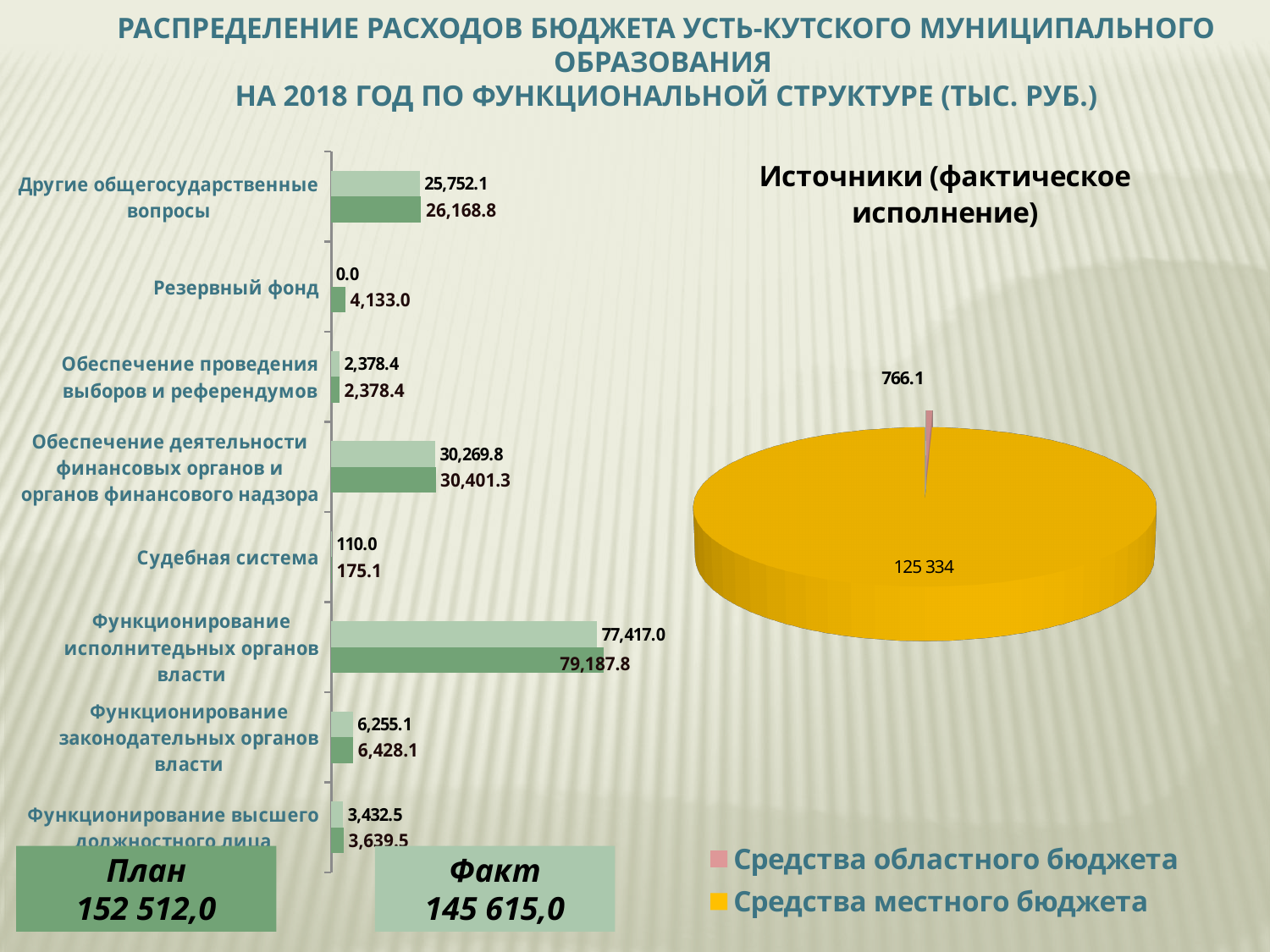
In the bar chart on the left, which category has the highest План (dark green) value? Функционирование исполнительных органов власти In the bar chart on the left, which is larger for «Функционирование законодательных органов власти»: the План value or the Факт value? План (6,428.1) What type of chart is the chart on the left of the slide? Bar chart In the bar chart on the left, what is the План (dark green) value for «Функционирование исполнительных органов власти»? 79,187.8 In the bar chart on the left, what is the Факт (light green) value for «Резервный фонд»? 0.0 In the pie chart «Источники (фактическое исполнение)», what is the value for «Средства областного бюджета»? 766.1 In the bar chart on the left, what is the difference between the План and Факт values for «Резервный фонд»? 4,133.0 How many categories are shown in the bar chart on the left? 8 In the bar chart on the left, what is the Факт (light green) value for «Другие общегосударственные вопросы»? 25,752.1 In the bar chart on the left, which category has the lowest План (dark green) value? Судебная система In the pie chart «Источники (фактическое исполнение)», what is the value for «Средства местного бюджета»? 125 334 How many entries does the legend of the pie chart «Источники (фактическое исполнение)» list? 2